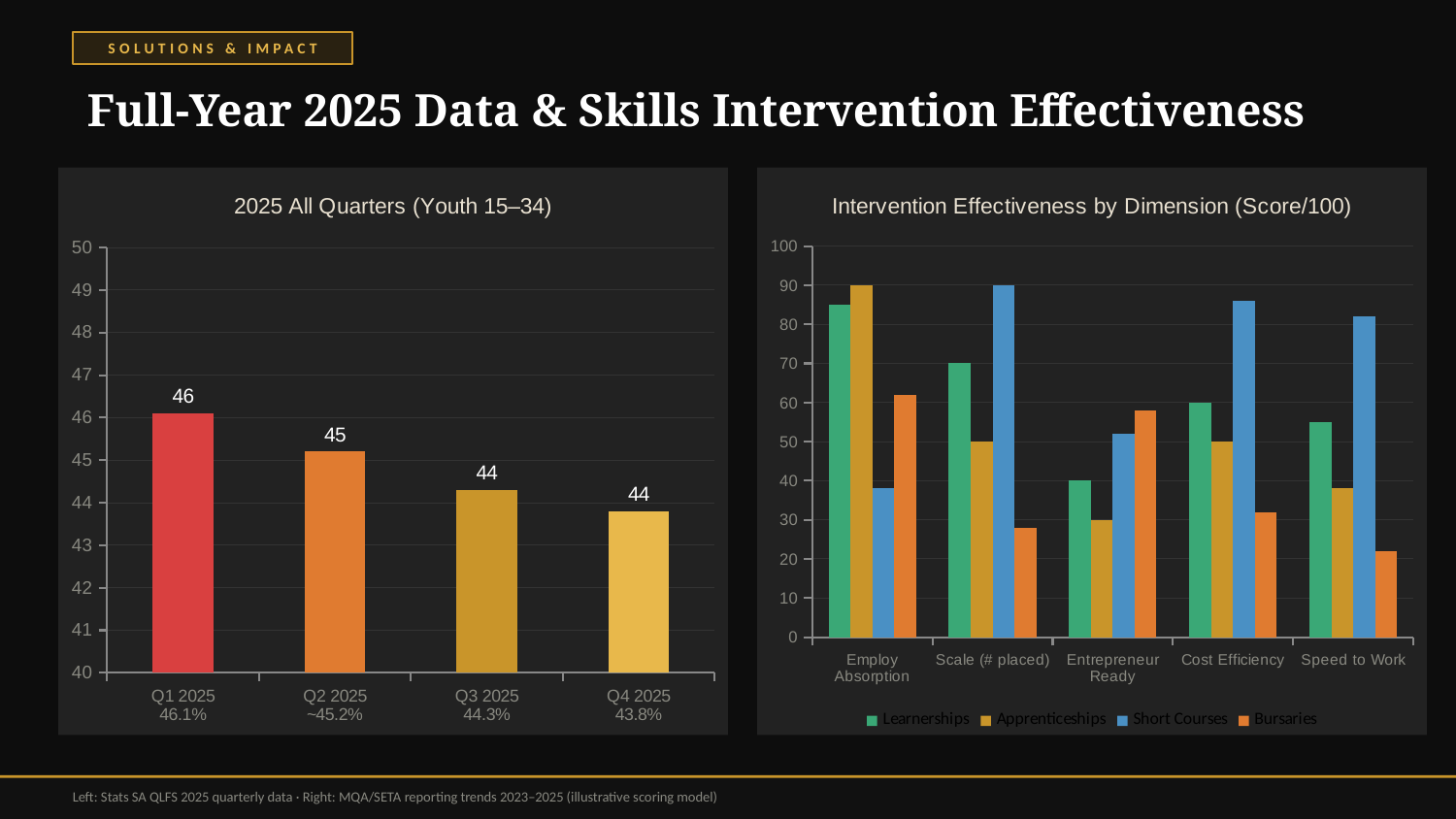
What kind of chart is the left chart, '2025 All Quarters (Youth 15–34)'? bar chart In the left chart '2025 All Quarters (Youth 15–34)', which quarter has the highest bar? Q1 2025 In the right chart 'Intervention Effectiveness by Dimension (Score/100)', is the Bursaries value for Speed to Work greater or less than 30? less How many bars are shown in the left chart '2025 All Quarters (Youth 15–34)'? 4 In the right chart 'Intervention Effectiveness by Dimension (Score/100)', which series has the highest score for Scale (# placed)? Short Courses In the left chart '2025 All Quarters (Youth 15–34)', what is the data label on the Q1 2025 bar? 46 In the right chart 'Intervention Effectiveness by Dimension (Score/100)', which is larger for Cost Efficiency: Short Courses or Bursaries? Short Courses How many series does the legend list in the right chart 'Intervention Effectiveness by Dimension (Score/100)'? 4 How many dimensions (categories) are shown on the x axis of the right chart 'Intervention Effectiveness by Dimension (Score/100)'? 5 In the left chart '2025 All Quarters (Youth 15–34)', do the values rise or fall from Q1 2025 to Q4 2025? fall In the right chart 'Intervention Effectiveness by Dimension (Score/100)', which series has the lowest score for Speed to Work? Bursaries In the left chart '2025 All Quarters (Youth 15–34)', what is the difference between the data labels for Q1 2025 and Q2 2025? 1